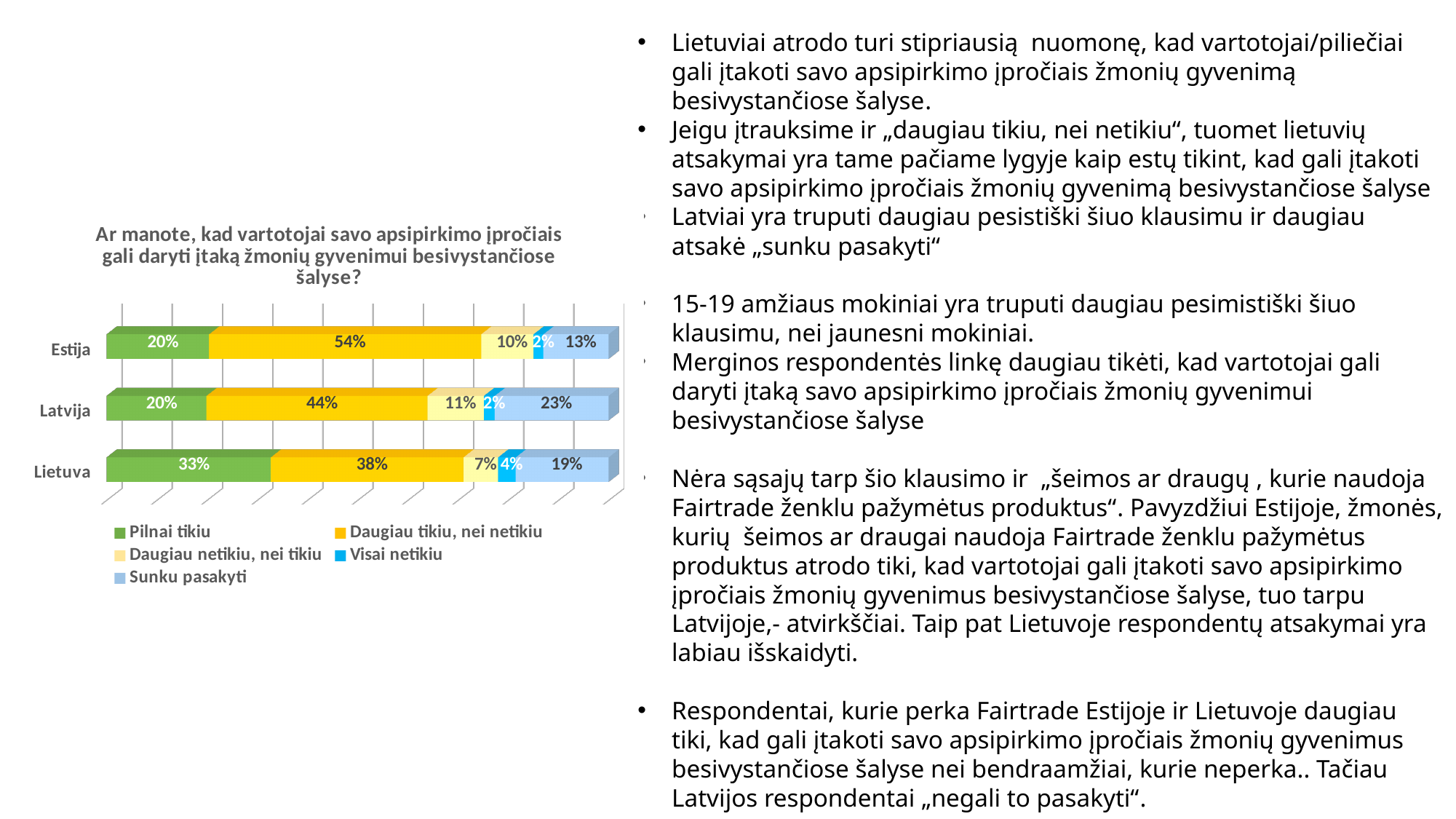
Which country has the highest 'Pilnai tikiu' value? Lietuva What is the 'Daugiau tikiu, nei netikiu' value for Estija? 54% Which legend entry is shown in green? Pilnai tikiu What is the difference between the 'Daugiau tikiu, nei netikiu' values for Estija and Latvija? 10% What kind of chart is shown on the slide? Stacked bar chart How many series does the chart legend list? 5 How many countries (categories) are shown in the chart? 3 Which is larger: the 'Daugiau netikiu, nei tikiu' value for Latvija or for Lietuva? Latvija Which country has the lowest 'Sunku pasakyti' value? Estija What is the 'Sunku pasakyti' value for Latvija? 23% What is the 'Visai netikiu' value for Lietuva? 4% What is the 'Pilnai tikiu' value for Lietuva? 33%